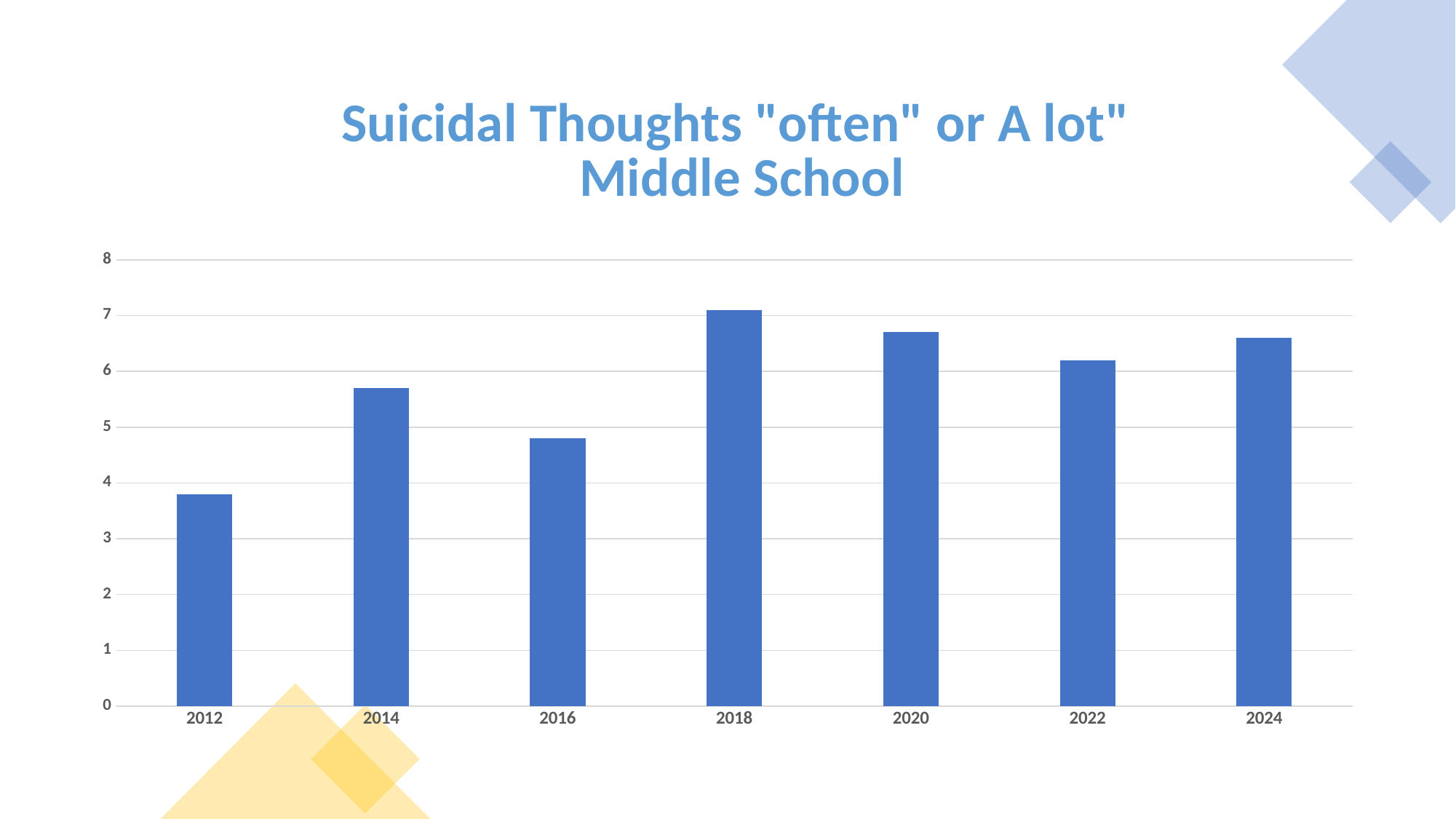
Is the value for 2016 greater or less than 5? less How many years are shown on the x axis of the chart? 7 Which year has the lowest value in the chart? 2012 Which year has the highest value in the chart? 2018 Which year has the larger value, 2014 or 2016? 2014 Is the value for 2012 greater or less than 4? less Is the value for 2020 greater or less than 6? greater What kind of chart is shown on the slide? bar chart Do the values rise or fall from 2018 to 2022? fall What is the title of the chart? Suicidal Thoughts "often" or A lot" Middle School Which year has the larger value, 2018 or 2022? 2018